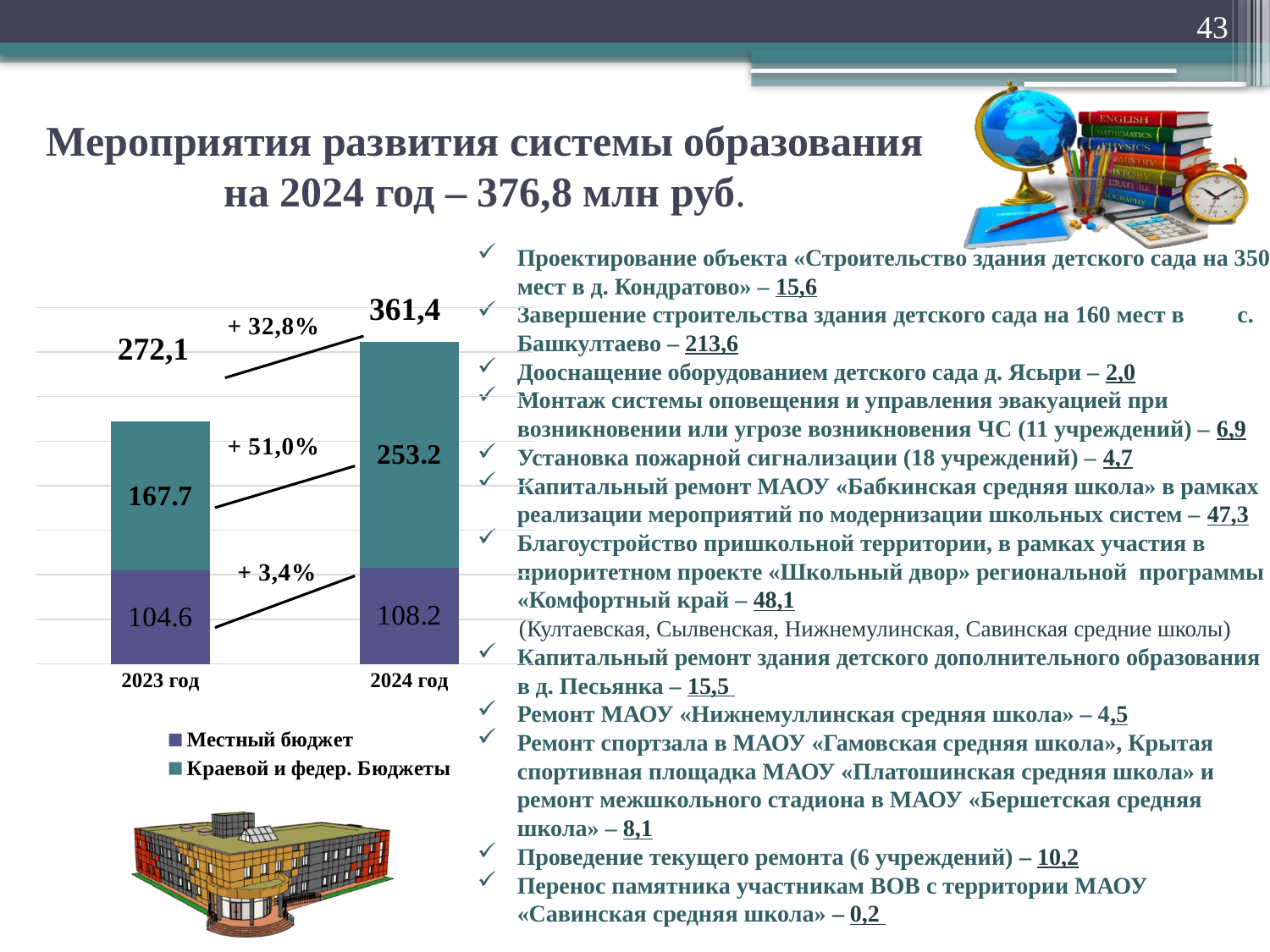
Which series is shown in purple in the chart? Местный бюджет What is the total of the stacked bar for 2024 год? 361,4 What is the value of Местный бюджет for 2023 год? 104.6 How many series does the chart legend list? 2 How many categories (years) are shown on the x axis of the chart? 2 What is the difference between the Местный бюджет values for 2024 год and 2023 год? 3.6 Which year has the higher total, 2023 год or 2024 год? 2024 год What percentage change is shown between the totals for 2023 год and 2024 год? + 32,8% What type of chart is shown on the slide? stacked bar chart What is the total of the stacked bar for 2023 год? 272,1 What is the value of Краевой и федер. Бюджеты for 2023 год? 167.7 What is the value of Краевой и федер. Бюджеты for 2024 год? 253.2